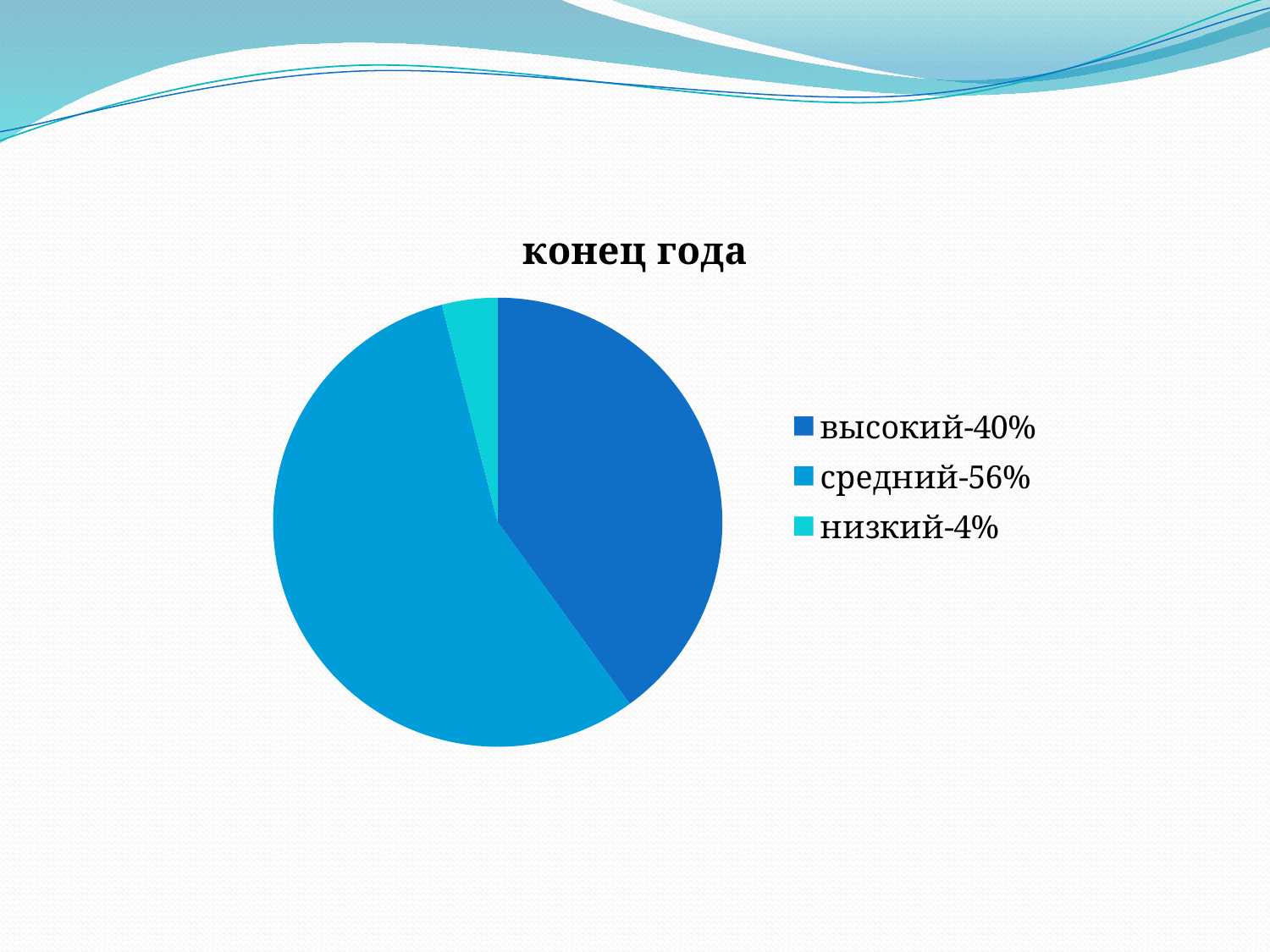
Which category has the largest slice of the pie? средний What share of the pie does the 'высокий' slice represent? 40% Which legend entry is shown in the lightest (turquoise) colour? низкий-4% What kind of chart is shown on the slide? pie chart Which category has the smallest slice of the pie? низкий Which is larger, the 'высокий' slice or the 'средний' slice? средний What is the title of the chart? конец года How many slices does the pie chart have? 3 How many entries does the legend list? 3 What share of the pie does the 'низкий' slice represent? 4% What share of the pie does the 'средний' slice represent? 56% What is the difference in percentage points between the 'средний' and 'высокий' slices? 16%